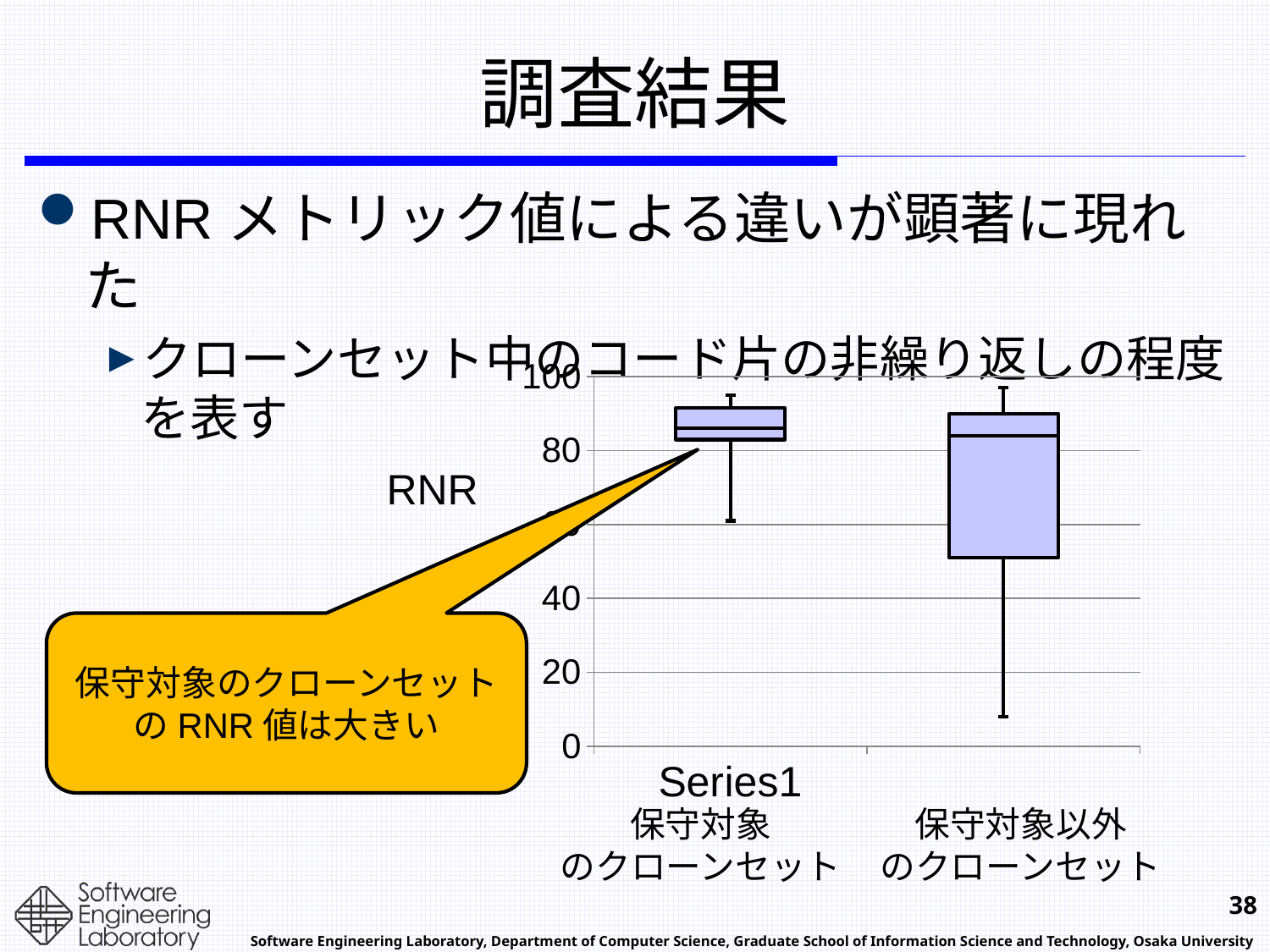
Is the bottom of the box for 保守対象以外のクローンセット greater or less than 40? greater How many categories (clone set groups) are plotted on the x axis? 2 Is the top of the box for 保守対象以外のクローンセット greater or less than 80? greater Which category has the wider spread (larger box) of RNR values, 保守対象のクローンセット or 保守対象以外のクローンセット? 保守対象以外のクローンセット Is the upper whisker for 保守対象以外のクローンセット greater or less than 80? greater What is the label on the vertical axis of the chart? RNR What kind of chart is shown on the slide? box plot What is the highest tick value shown on the vertical axis? 100 Which category has the lower minimum RNR value, 保守対象のクローンセット or 保守対象以外のクローンセット? 保守対象以外のクローンセット